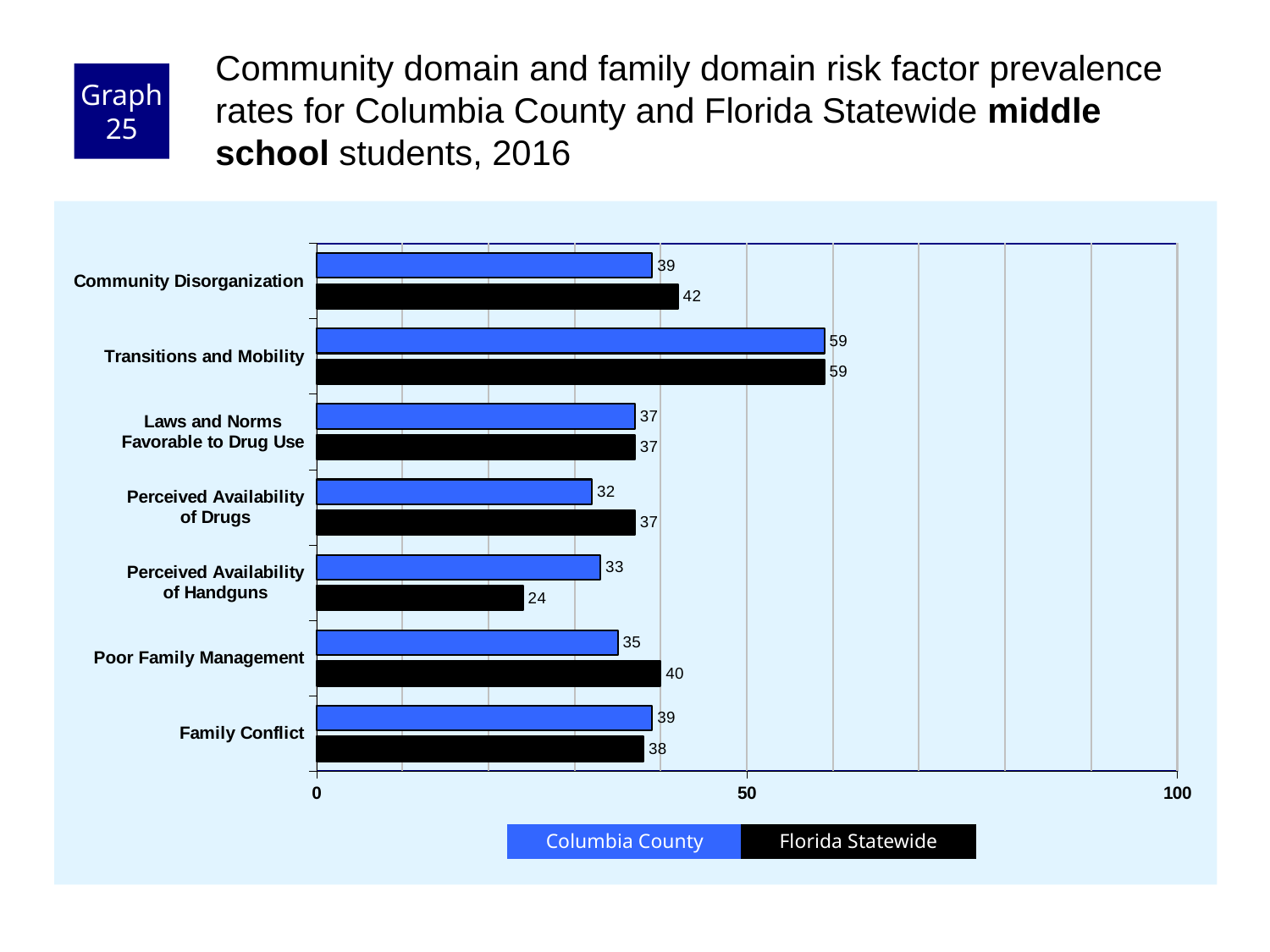
Which risk factor has the lowest Florida Statewide value? Perceived Availability of Handguns What is the Florida Statewide value for Poor Family Management? 40 What kind of chart is shown on the slide? bar chart How many risk factor categories are shown on the chart? 7 What is the Florida Statewide value for Perceived Availability of Handguns? 24 What is the difference between the Florida Statewide and Columbia County values for Community Disorganization? 3 What is the difference between the Florida Statewide and Columbia County values for Perceived Availability of Handguns? 9 For Poor Family Management, which is larger: the Columbia County value or the Florida Statewide value? Florida Statewide Which risk factor has the highest Columbia County value? Transitions and Mobility What is the Columbia County value for Perceived Availability of Drugs? 32 Is the Columbia County value for Transitions and Mobility greater or less than 50? greater How many series does the legend list? 2